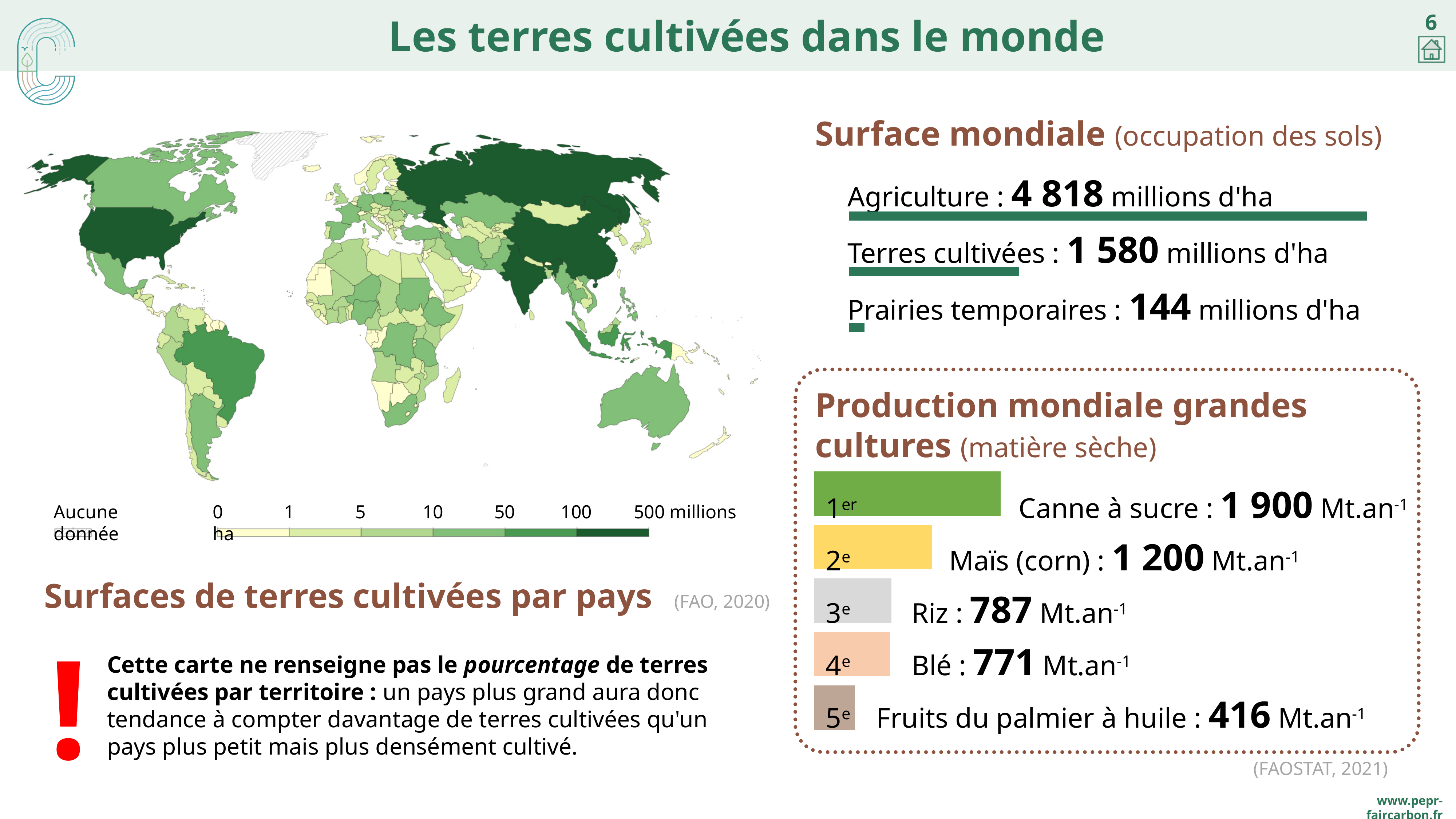
In the 'Production mondiale grandes cultures' chart, which crop has the highest production? Canne à sucre In the 'Surface mondiale' chart, what is the value for Terres cultivées? 1 580 millions d'ha In the 'Production mondiale grandes cultures' chart, which crop has the lowest production? Fruits du palmier à huile In the 'Surface mondiale' chart, what is the value for Prairies temporaires? 144 millions d'ha In the 'Surface mondiale' chart, what is the difference between Agriculture and Terres cultivées? 3 238 millions d'ha In the 'Surface mondiale' chart, which is larger: Agriculture or Terres cultivées? Agriculture In the 'Production mondiale grandes cultures' chart, what is the value for Canne à sucre? 1 900 Mt.an-1 In the 'Production mondiale grandes cultures' chart, how many crops are shown? 5 In the 'Production mondiale grandes cultures' chart, what is the difference between Canne à sucre and Maïs (corn)? 700 Mt.an-1 On the map 'Surfaces de terres cultivées par pays', what is the highest value shown on the colour legend? 500 millions ha What kind of chart is used in the 'Production mondiale grandes cultures' section? Bar chart In the 'Production mondiale grandes cultures' chart, what is the value for Riz? 787 Mt.an-1